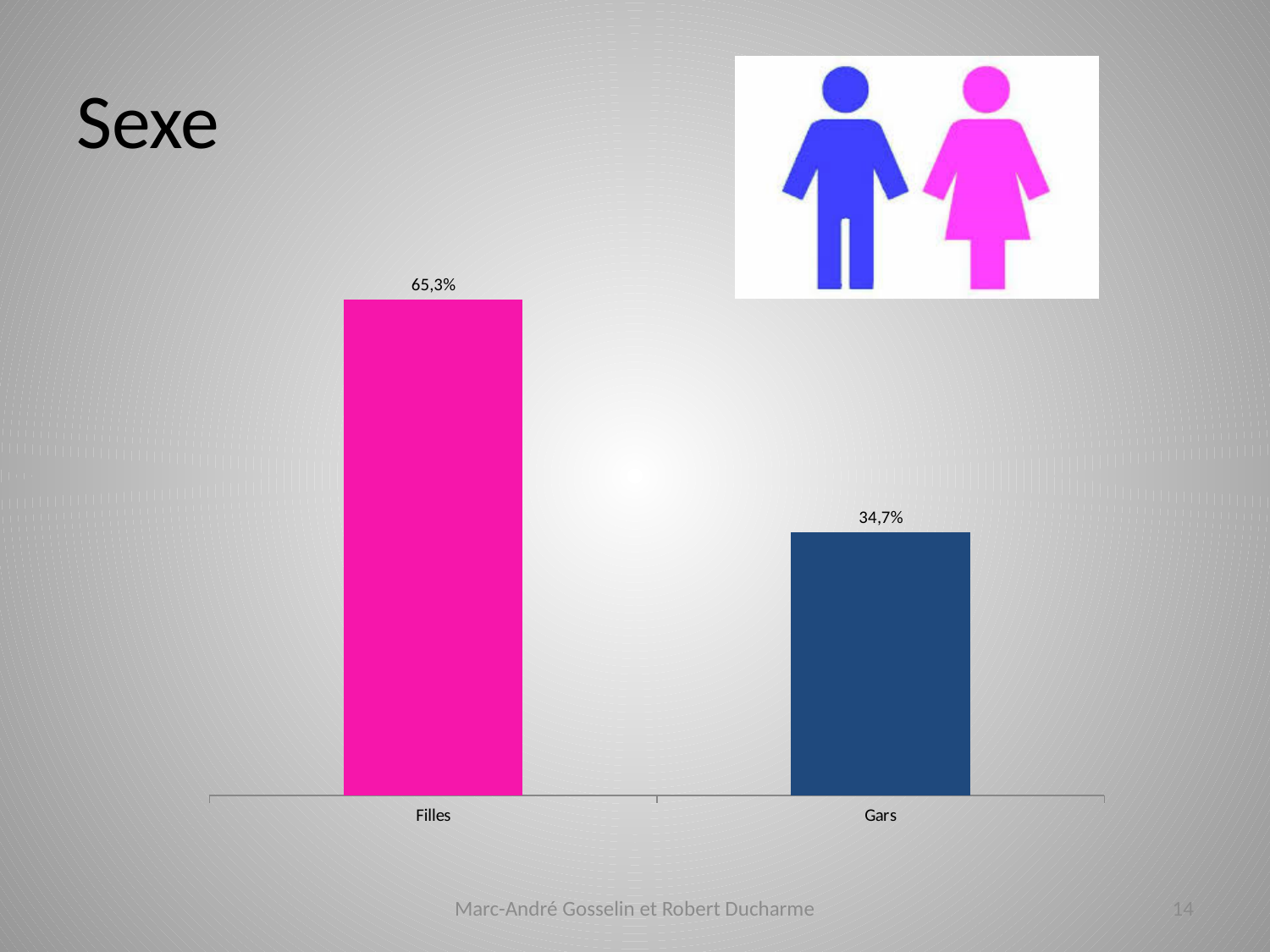
Which category has the highest value? Filles Which is larger, the value for Filles or the value for Gars? Filles How many categories are shown in the chart? 2 What is the value for Filles? 65,3% Which category has the lowest value? Gars What is the difference between the values for Filles and Gars? 30,6% What colour is the bar for Filles? Pink What is the total of the values for Filles and Gars? 100% What is the title of the slide containing the chart? Sexe What is the value for Gars? 34,7% What kind of chart is shown on the slide? Bar chart